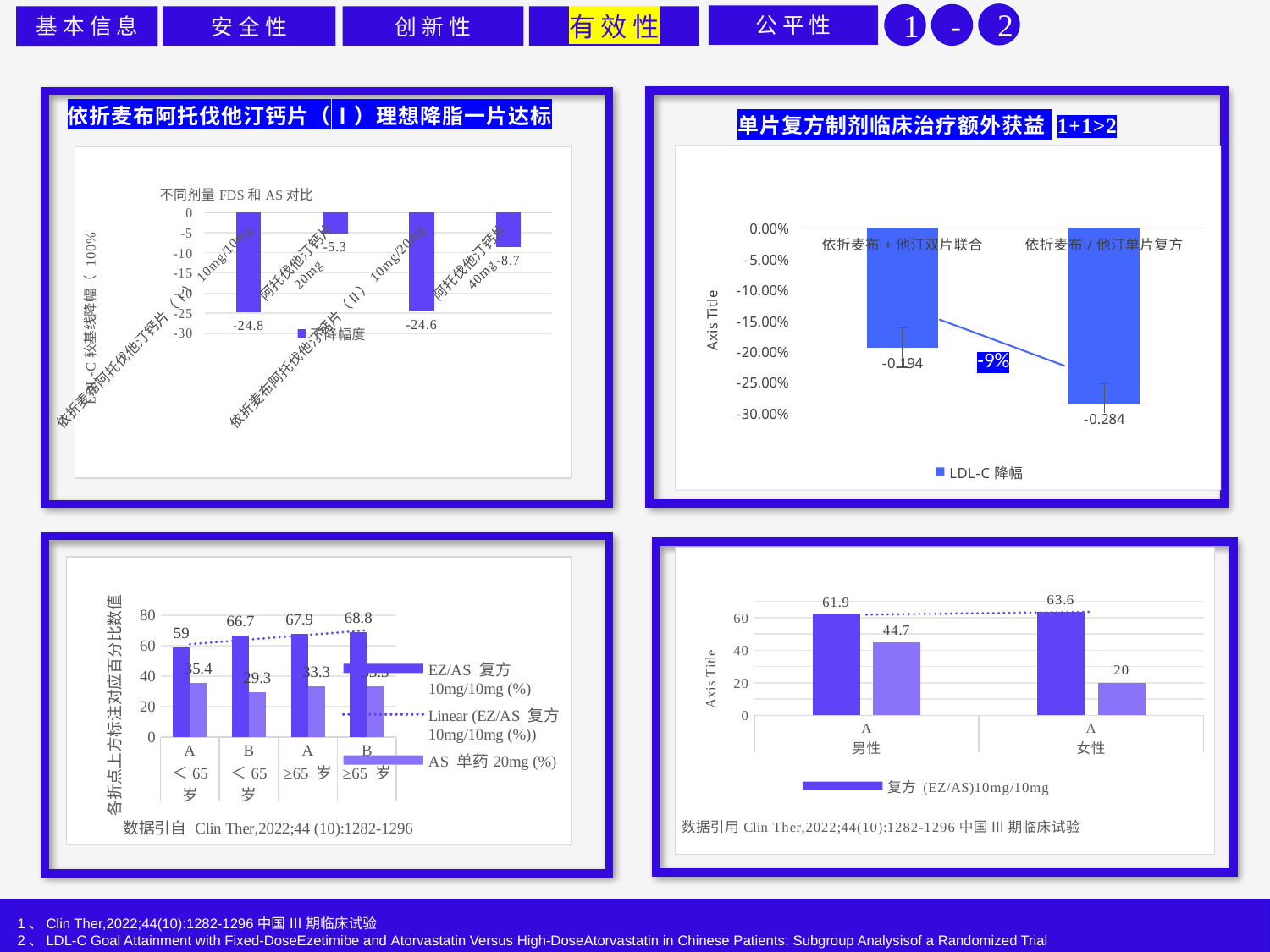
In the bottom-right chart, what is the difference between the two bars shown for 男性 (61.9 and 44.7)? 17.2 In the bottom-left chart, which category has the lowest EZ/AS 复方 10mg/10mg (%) value? A <65 岁 In the bottom-left chart, what is the AS 单药 20mg (%) value for category A <65 岁? 35.4 In the top-left chart titled 不同剂量 FDS 和 AS 对比, how many bars are plotted? 4 In the top-left chart titled 不同剂量 FDS 和 AS 对比, what is the difference between the values for 阿托伐他汀钙片 40mg and 阿托伐他汀钙片 20mg? 3.4 In the top-right chart titled 单片复方制剂临床治疗额外获益, what series name does the legend show? LDL-C 降幅 In the top-left chart titled 不同剂量 FDS 和 AS 对比, what is the value for 阿托伐他汀钙片 20mg? -5.3 In the bottom-left chart, what is the EZ/AS 复方 10mg/10mg (%) value for category B ≥65 岁? 68.8 In the top-left chart titled 不同剂量 FDS 和 AS 对比, what is the value for 依折麦布阿托伐他汀钙片（Ⅰ）10mg/10mg? -24.8 In the bottom-right chart, what is the value of the 复方 (EZ/AS)10mg/10mg bar for 女性? 63.6 In the top-right chart titled 单片复方制剂临床治疗额外获益, what is the value for 依折麦布/他汀单片复方? -0.284 In the top-right chart titled 单片复方制剂临床治疗额外获益, what is the value for 依折麦布＋他汀双片联合? -0.194